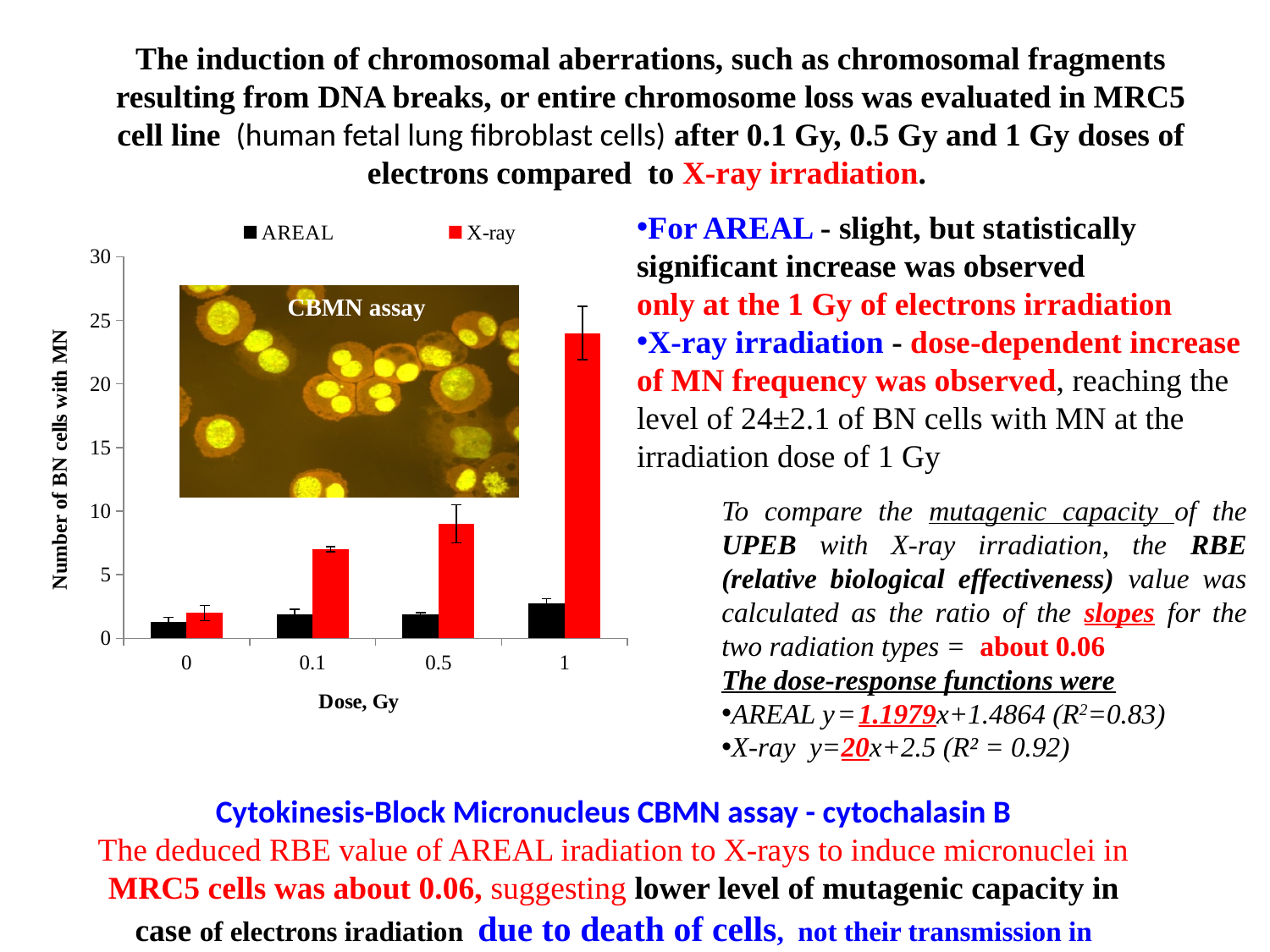
Is the X-ray value at a dose of 0.1 Gy greater or less than 10? less Do the X-ray values rise or fall as the dose increases along the x axis? rise What kind of chart is shown on the slide? bar chart How many series does the chart legend list? 2 Is the X-ray value at a dose of 1 Gy greater or less than 20? greater At which dose is the X-ray value highest? 1 Is the AREAL value at a dose of 1 Gy greater or less than 5? less What is the title of the y axis of the chart? Number of BN cells with MN At a dose of 1 Gy, which series has the larger value, AREAL or X-ray? X-ray How many dose categories are shown on the x axis of the chart? 4 What are the two series named in the chart legend? AREAL and X-ray